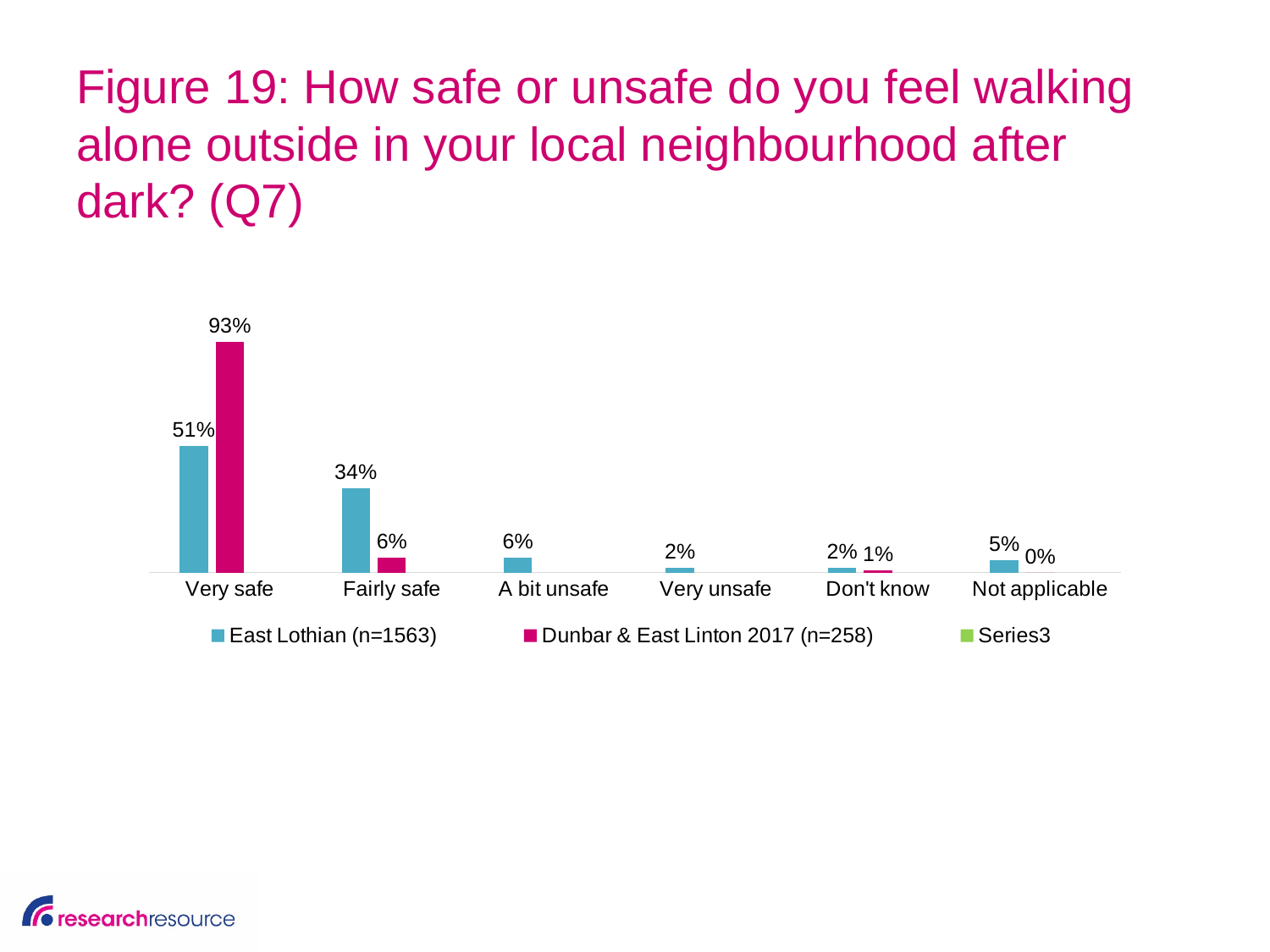
What is the Dunbar & East Linton 2017 value for 'Fairly safe'? 6% What is the East Lothian value for 'Fairly safe'? 34% What is the sample size (n) shown in the legend for East Lothian? 1563 What is the East Lothian value for 'Not applicable'? 5% What kind of chart is shown on the slide? Bar chart Which category has the highest value for the Dunbar & East Linton 2017 series? Very safe For 'Fairly safe', which series has the larger value: East Lothian or Dunbar & East Linton 2017? East Lothian What percentage of Dunbar & East Linton 2017 respondents said they feel very safe? 93% What is the difference between the Dunbar & East Linton 2017 and East Lothian values for 'Very safe'? 42 percentage points How many series does the legend list? 3 How many response categories are shown on the x axis? 6 What percentage of East Lothian respondents said they feel very safe walking alone after dark? 51%